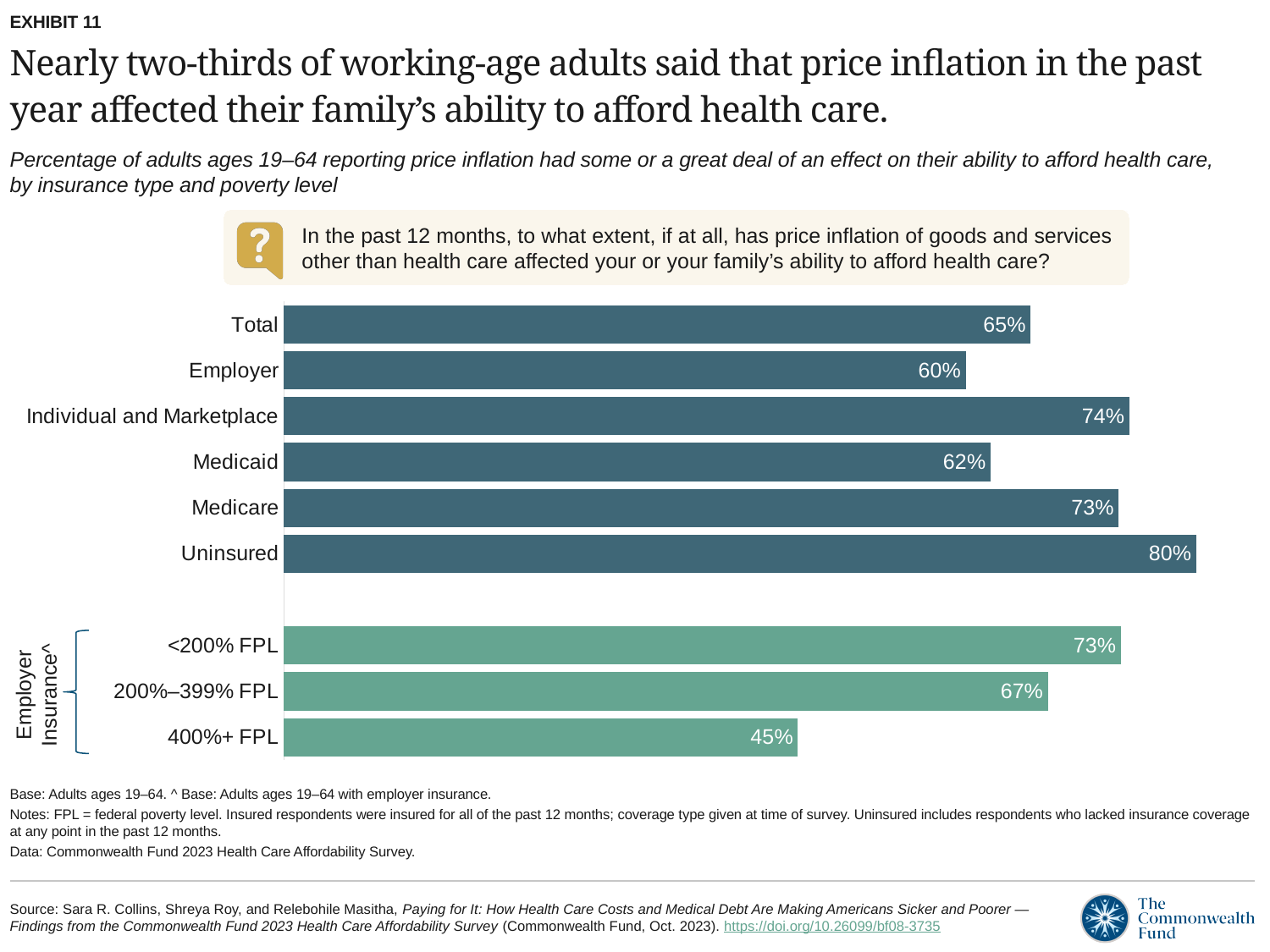
What type of chart is shown on the slide? Bar chart What is the difference in percentage points between the Uninsured and Employer values? 20 percentage points Which category has the highest value on the chart? Uninsured What percentage is shown for adults with employer insurance at 400%+ FPL? 45% What is the difference between the <200% FPL and 400%+ FPL values? 28 percentage points What percentage of adults with Employer insurance reported that price inflation affected their ability to afford health care? 60% Which category has the lowest value on the chart? 400%+ FPL Which three categories are grouped under the 'Employer Insurance^' bracket? <200% FPL, 200%–399% FPL, 400%+ FPL Which is larger, the value for Individual and Marketplace or the value for Medicaid? Individual and Marketplace What is the value shown for the Uninsured category? 80% What is the value shown for the Total bar? 65% How many bars are plotted on the chart? 9